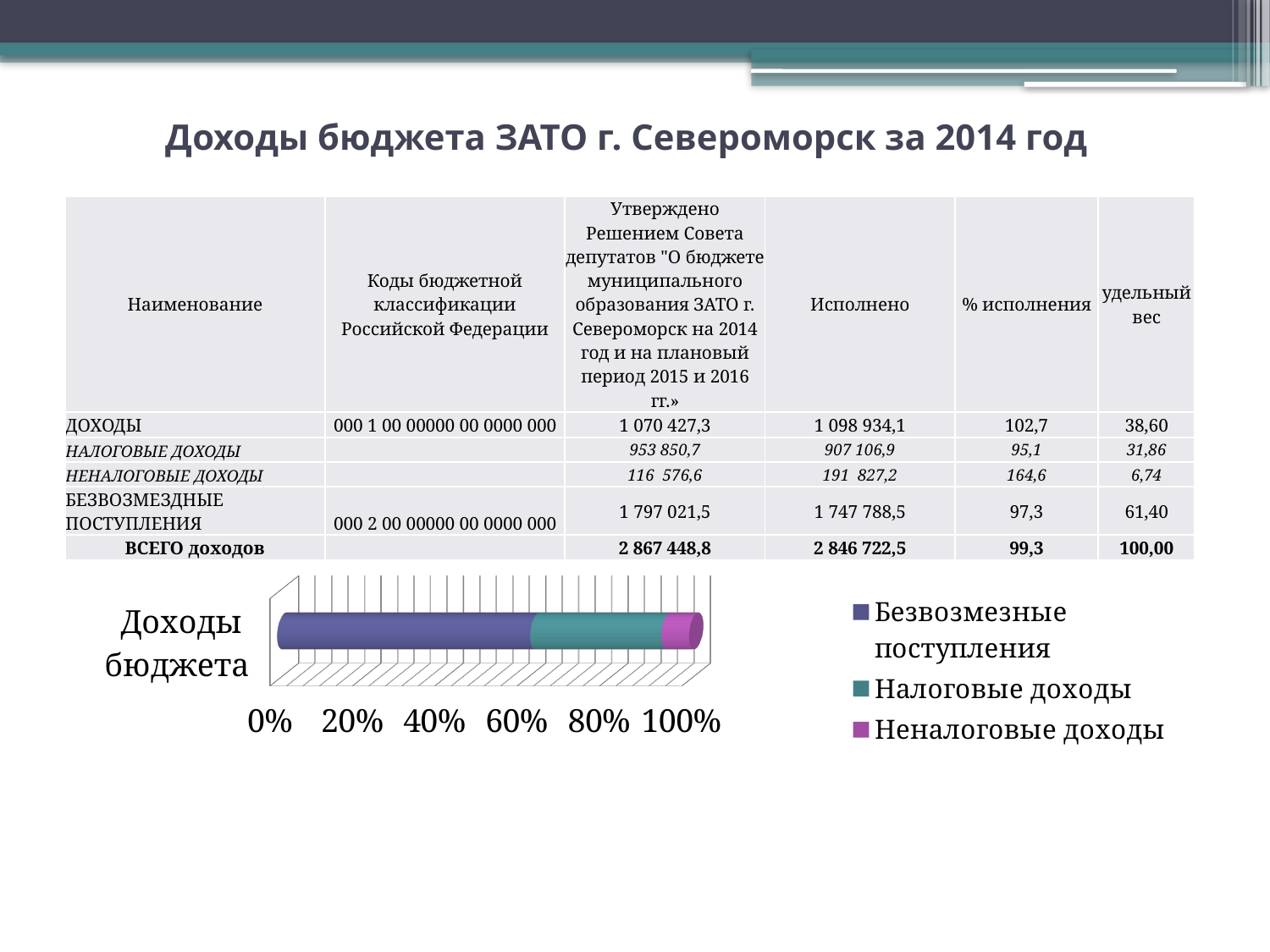
Which series takes up the largest share of the bar in the chart? Безвозмезные поступления In the chart, which segment is larger: Безвозмезные поступления or Налоговые доходы? Безвозмезные поступления Is the share of Безвозмезные поступления in the chart's bar greater or less than 40%? greater Which series takes up the smallest share of the bar in the chart? Неналоговые доходы In the chart, which segment is larger: Налоговые доходы or Неналоговые доходы? Налоговые доходы What kind of chart is shown on the slide? bar chart How many series does the chart legend list? 3 What is the label of the single category on the chart's vertical axis? Доходы бюджета Which series is listed first in the chart legend? Безвозмезные поступления How many categories are plotted on the chart's vertical axis? 1 Is the share of Неналоговые доходы in the chart's bar greater or less than 20%? less What is the highest value shown on the chart's horizontal axis? 100%